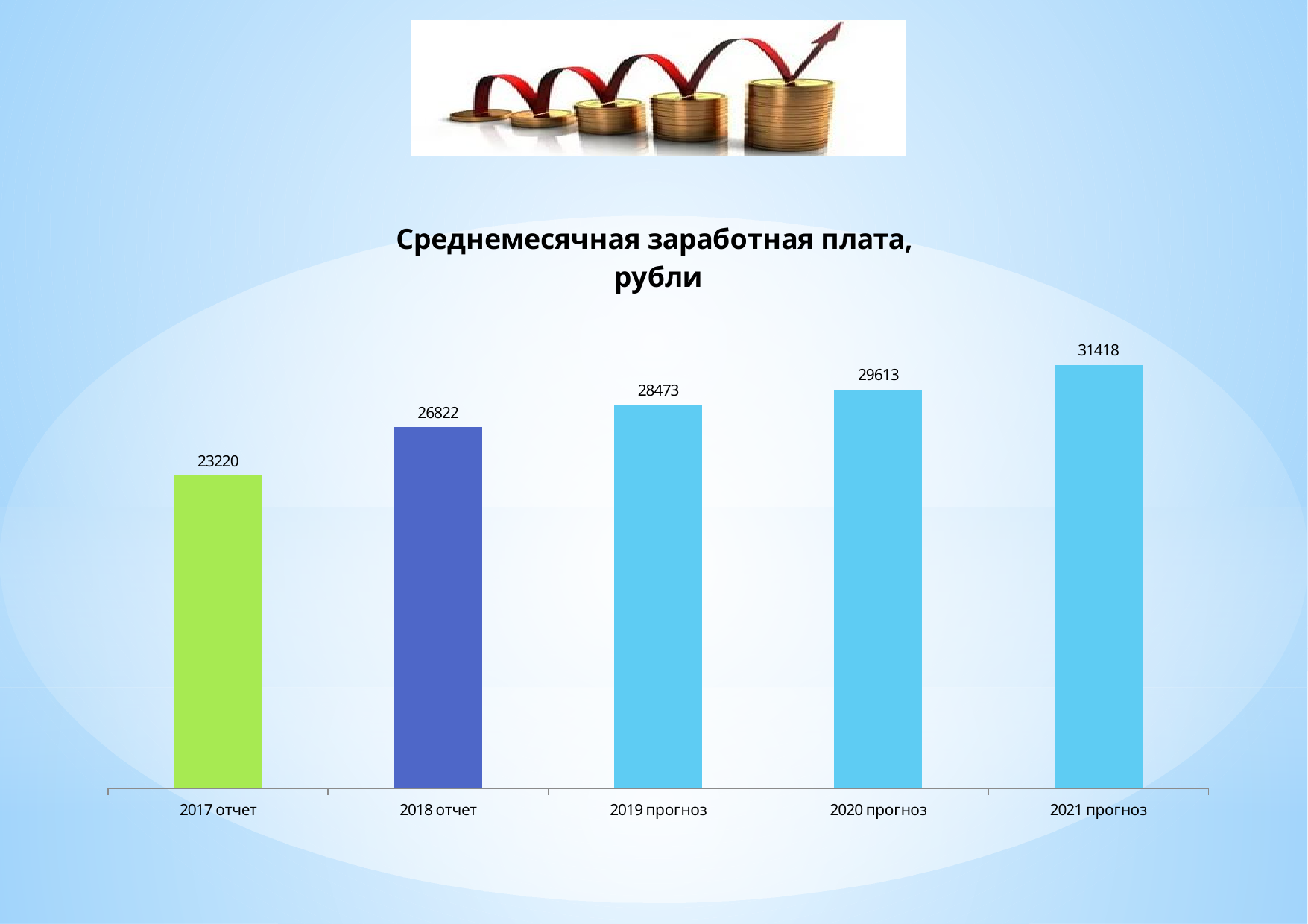
What is the value for 2021 прогноз? 31418 What is the difference between the values for 2018 отчет and 2017 отчет? 3602 Do the values rise or fall from 2017 отчет to 2021 прогноз? rise What is the value for 2017 отчет? 23220 What is the difference between the values for 2021 прогноз and 2020 прогноз? 1805 What kind of chart is shown on the slide? bar chart Which category has the highest value? 2021 прогноз Which is larger, the value for 2019 прогноз or the value for 2020 прогноз? 2020 прогноз How many categories are shown on the x axis? 5 Which category has the lowest value? 2017 отчет What is the title of the chart? Среднемесячная заработная плата, рубли What is the value for 2019 прогноз? 28473